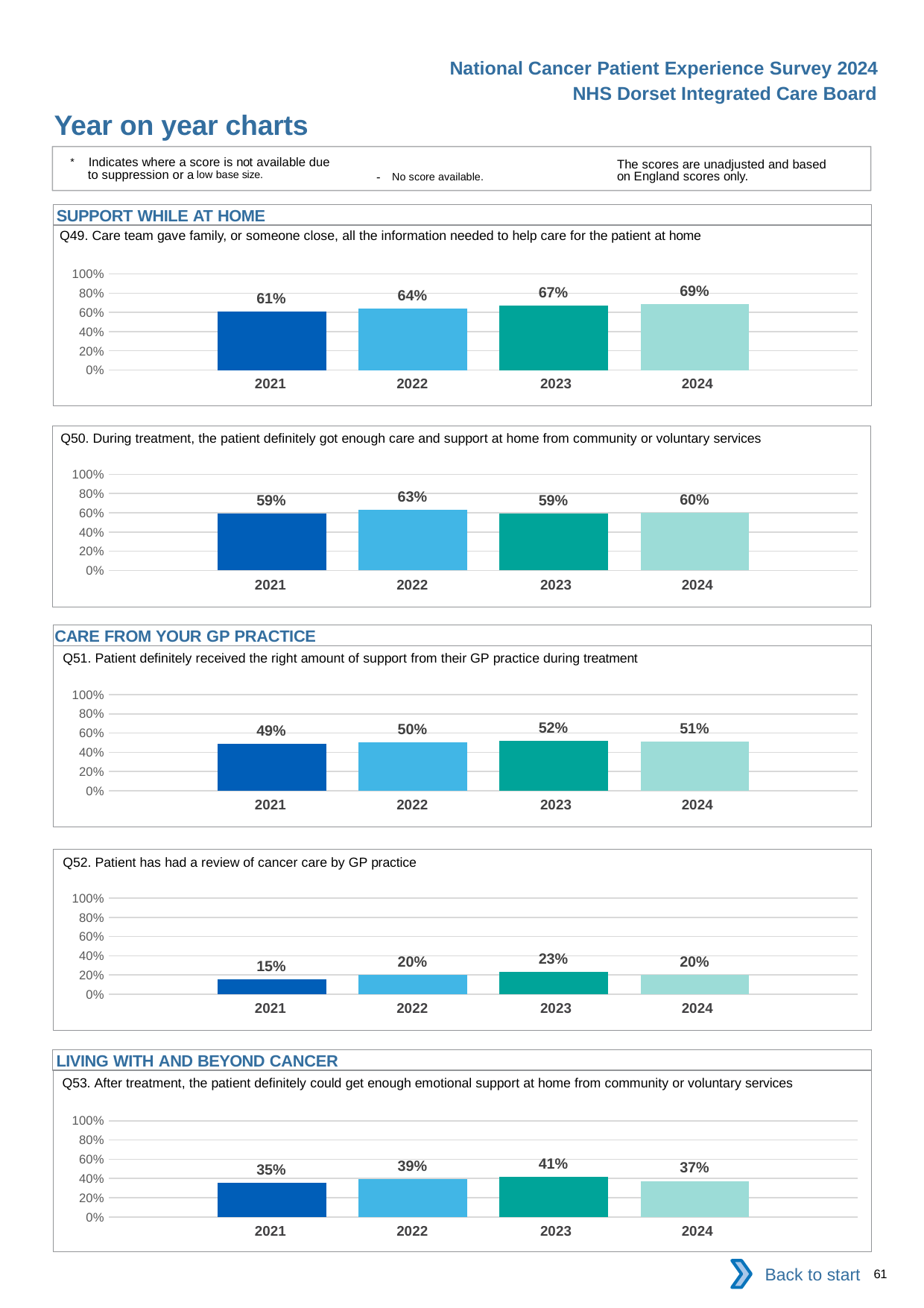
In the Q49 chart, what is the value for 2024? 69% In the Q53 chart, which year has the highest value? 2023 In the Q51 chart, which is larger, the value for 2023 or the value for 2021? 2023 In the Q51 chart, what is the value for 2023? 52% What kind of chart is the Q52 chart? bar chart In the Q50 chart, which year has the highest value? 2022 In the Q50 chart, what is the difference between the 2022 value and the 2021 value? 4% In the Q52 chart, what is the difference between the 2023 value and the 2021 value? 8% In the Q49 chart, do the values rise or fall from 2021 to 2024? rise In the Q52 chart, what is the value for 2021? 15% In the Q49 chart, which year has the lowest value? 2021 How many years are shown on the x axis of the Q53 chart? 4